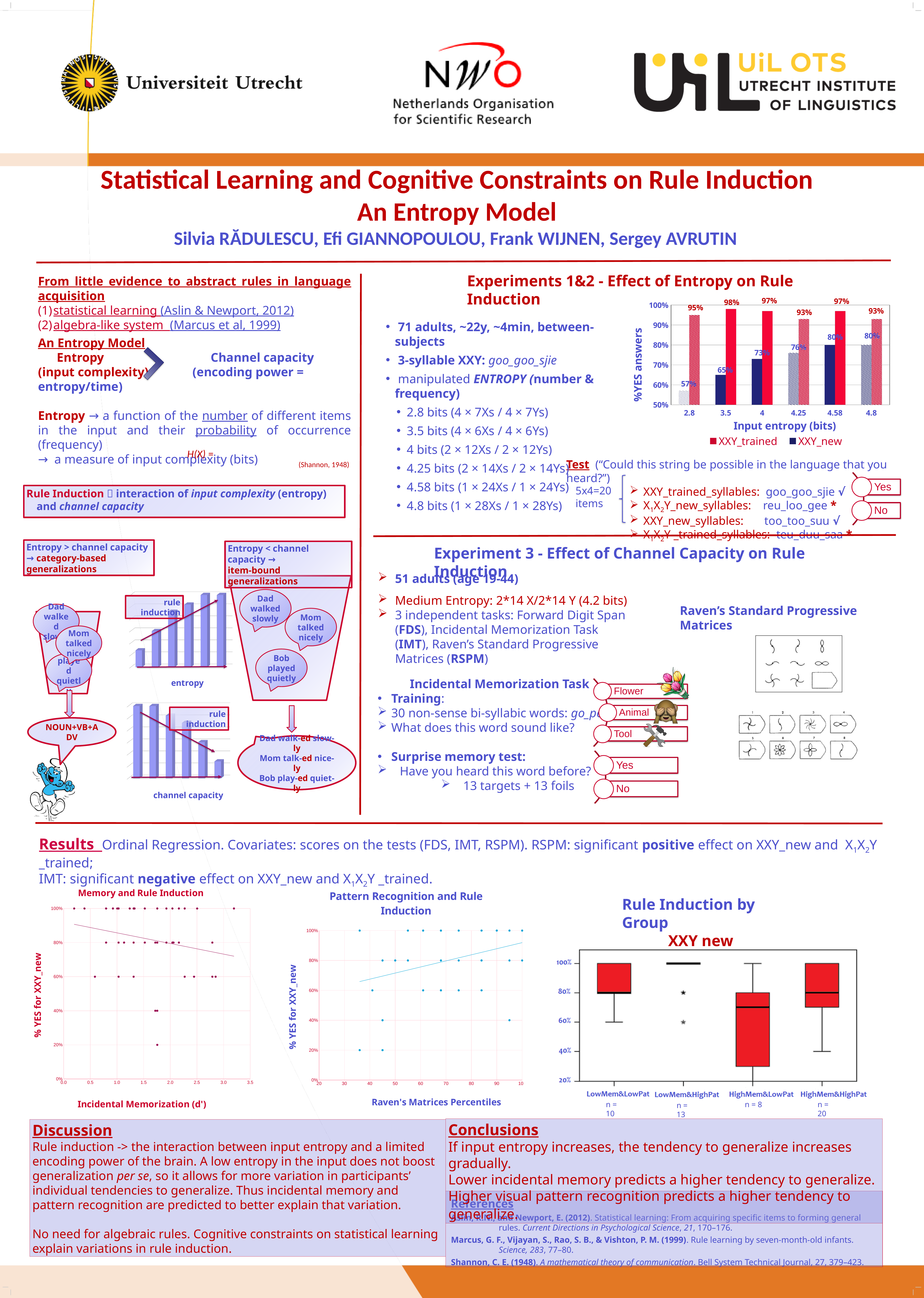
In the bar chart of %YES answers by input entropy, which is larger: XXY_new at 4.25 bits or XXY_new at 4 bits? XXY_new at 4.25 bits In the bar chart of %YES answers by input entropy, do the XXY_new values rise or fall as input entropy increases? rise In the bar chart of %YES answers by input entropy, at which input entropy is the XXY_trained value highest? 3.5 In the bar chart of %YES answers by input entropy, at which input entropy is the XXY_new value lowest? 2.8 How many input entropy categories are shown on the x axis of the bar chart of %YES answers? 6 In the bar chart of %YES answers by input entropy, what is the value for XXY_new at 4 bits? 73% How many series does the legend of the bar chart of %YES answers list? 2 In the bar chart of %YES answers by input entropy, what is the difference between XXY_trained and XXY_new at 2.8 bits? 38 percentage points In the bar chart of %YES answers by input entropy, what is the value for XXY_trained at 2.8 bits? 95% What kind of chart is the %YES answers by input entropy chart? bar chart In the 'Memory and Rule Induction' scatter chart, does the fitted line rise or fall as Incidental Memorization (d') increases? fall In the bar chart of %YES answers by input entropy, what is the value for XXY_new at 2.8 bits? 57%